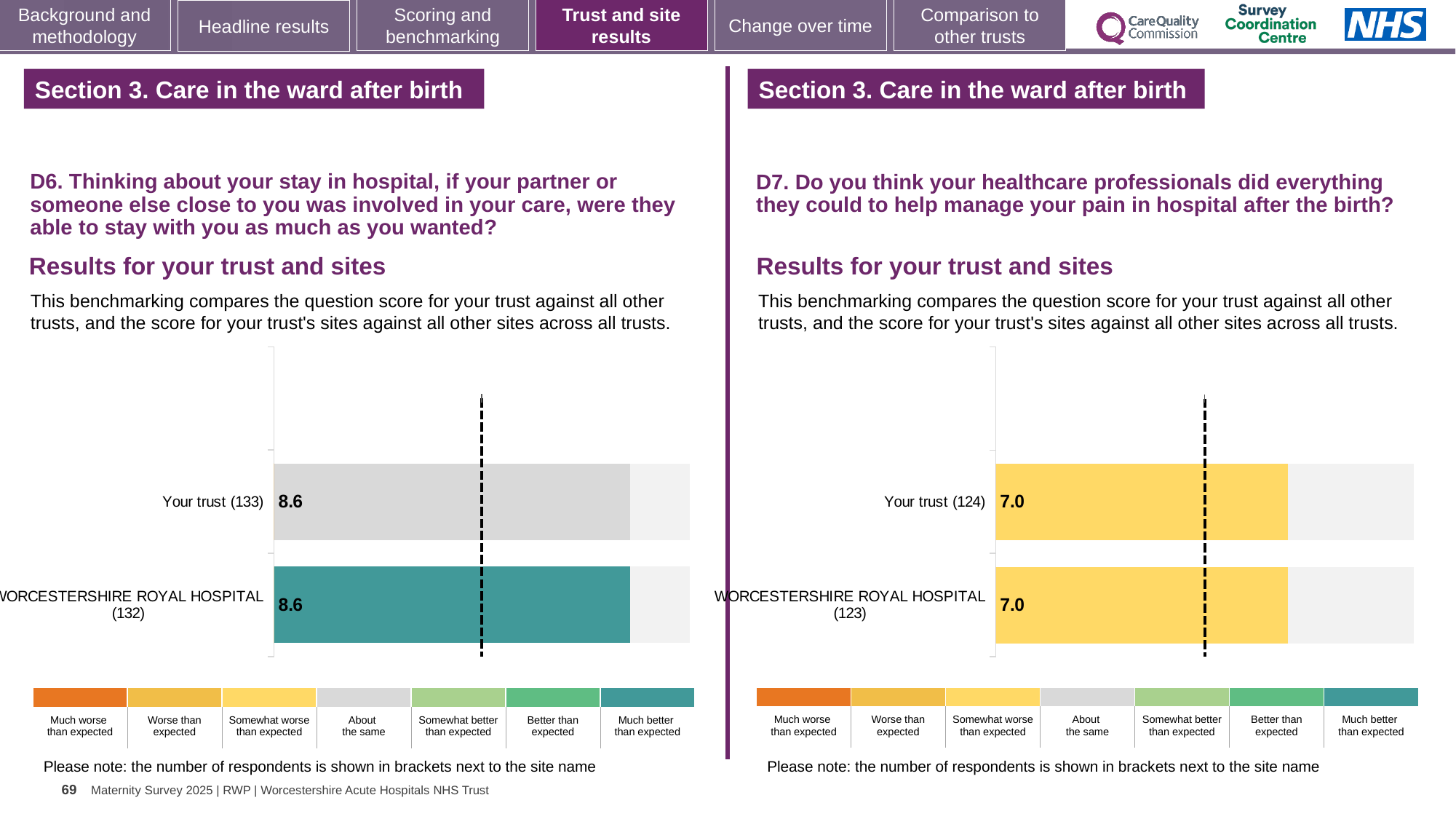
On the left chart (D6), what is the difference between the score for Your trust and the score for WORCESTERSHIRE ROYAL HOSPITAL? 0.0 On the left chart (D6), which benchmark category does the colour of the WORCESTERSHIRE ROYAL HOSPITAL bar correspond to? Much better than expected On the right chart (D7), what is the score for WORCESTERSHIRE ROYAL HOSPITAL (123)? 7.0 What kind of chart is used on the left (D6)? Bar chart On the right chart (D7), which benchmark category does the colour of the Your trust bar correspond to? Somewhat worse than expected How many bars are plotted on the right chart (D7)? 2 On the right chart (D7), what is the score for Your trust (124)? 7.0 How many bars are plotted on the left chart (D6)? 2 On the left chart (D6), what is the score for Your trust (133)? 8.6 On the left chart (D6), what is the score for WORCESTERSHIRE ROYAL HOSPITAL (132)? 8.6 On the right chart (D7), what is the difference between the score for Your trust and the score for WORCESTERSHIRE ROYAL HOSPITAL? 0.0 How many respondents are shown in brackets for Your trust on the right chart (D7)? 124